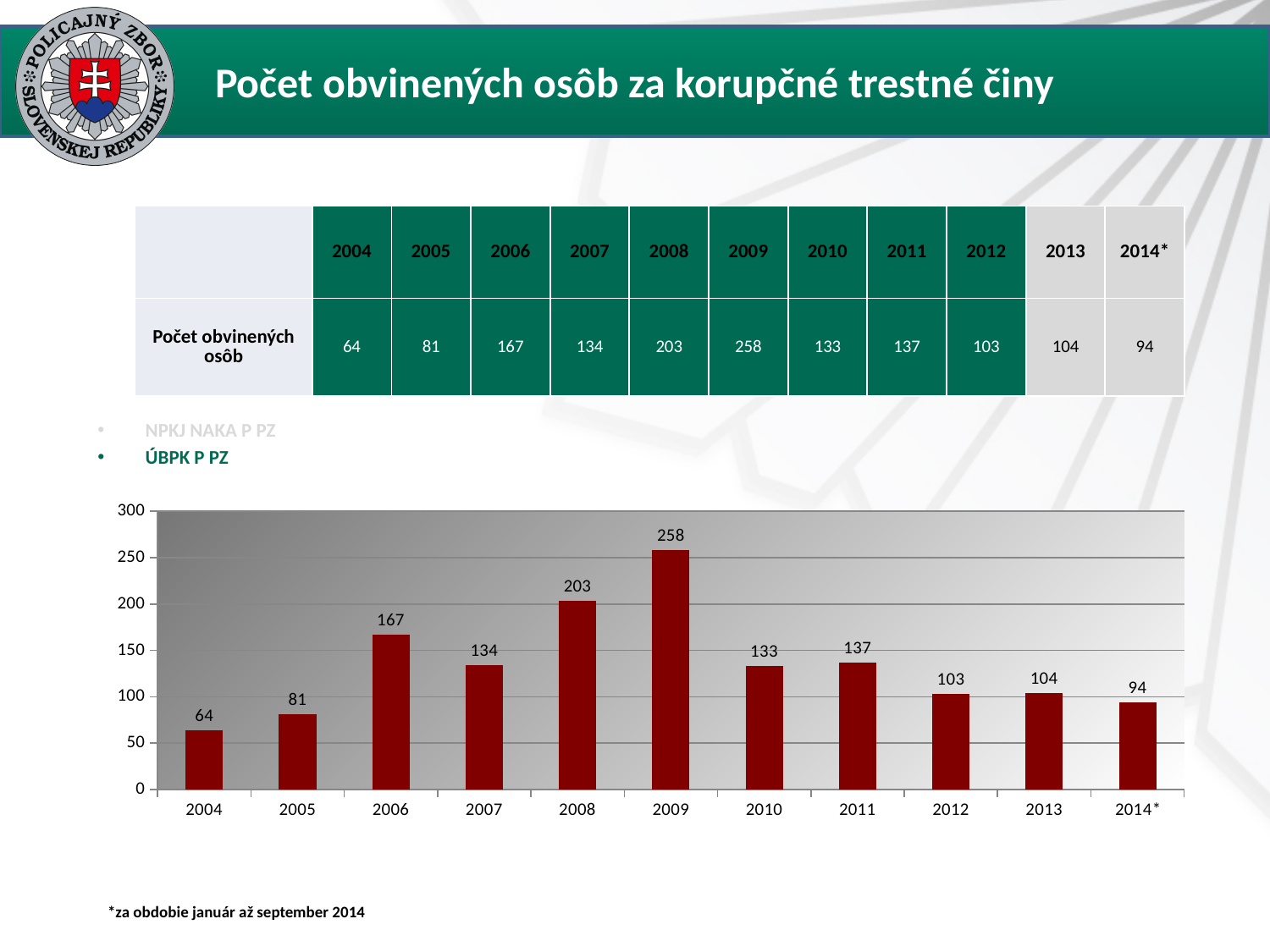
How many years are shown on the x axis of the bar chart? 11 What kind of chart is shown on the slide? bar chart Do the values in the bar chart rise or fall from 2009 to 2012? fall What is the value for 2014* in the bar chart? 94 Which year has the highest value in the bar chart? 2009 What is the difference between the values for 2009 and 2008 in the bar chart? 55 What is the value for 2004 in the bar chart? 64 What colour are the bars in the chart? dark red Which is larger in the bar chart, the value for 2006 or the value for 2007? 2006 Which year has the lowest value in the bar chart? 2004 Is the value for 2008 in the bar chart greater or less than 200? greater What is the value for 2009 in the bar chart? 258